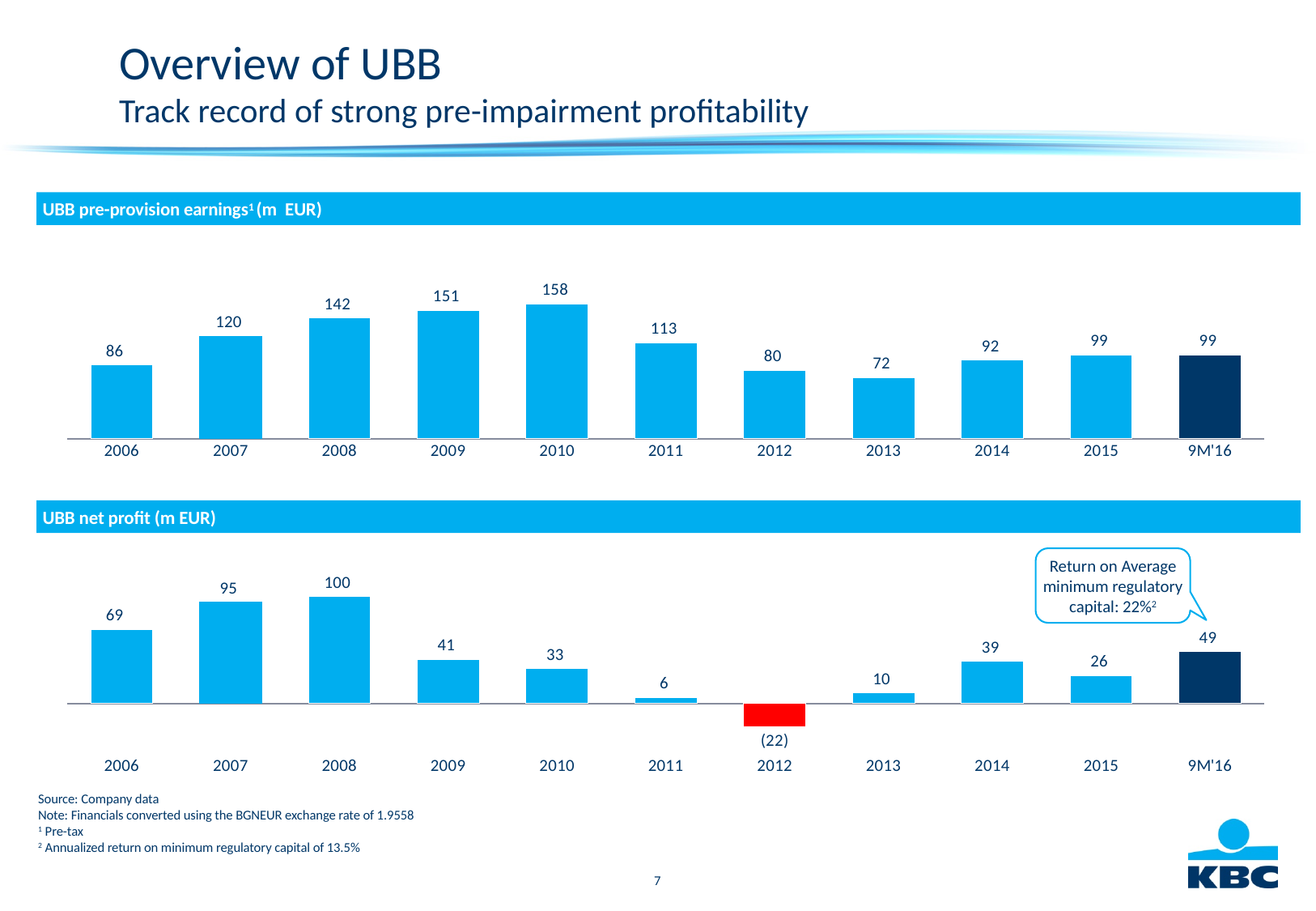
In the UBB pre-provision earnings chart, do values rise or fall from 2006 to 2010? rise What kind of chart is the UBB net profit chart? bar chart In the UBB net profit chart, what colour is the bar for 2012? red In the UBB pre-provision earnings chart, what is the difference between the 2010 and 2013 values? 86 In the UBB net profit chart, what is the difference between the 2007 and 2009 values? 54 In the UBB pre-provision earnings chart, how many categories are shown on the x axis? 11 In the UBB net profit chart, what is the value for 9M'16? 49 In the UBB net profit chart, which is larger, the value for 2014 or the value for 2015? 2014 In the UBB pre-provision earnings chart, which year has the lowest value? 2013 In the UBB pre-provision earnings chart, what is the value for 2010? 158 In the UBB net profit chart, what is the value for 2012? (22) In the UBB net profit chart, which year has the highest value? 2008